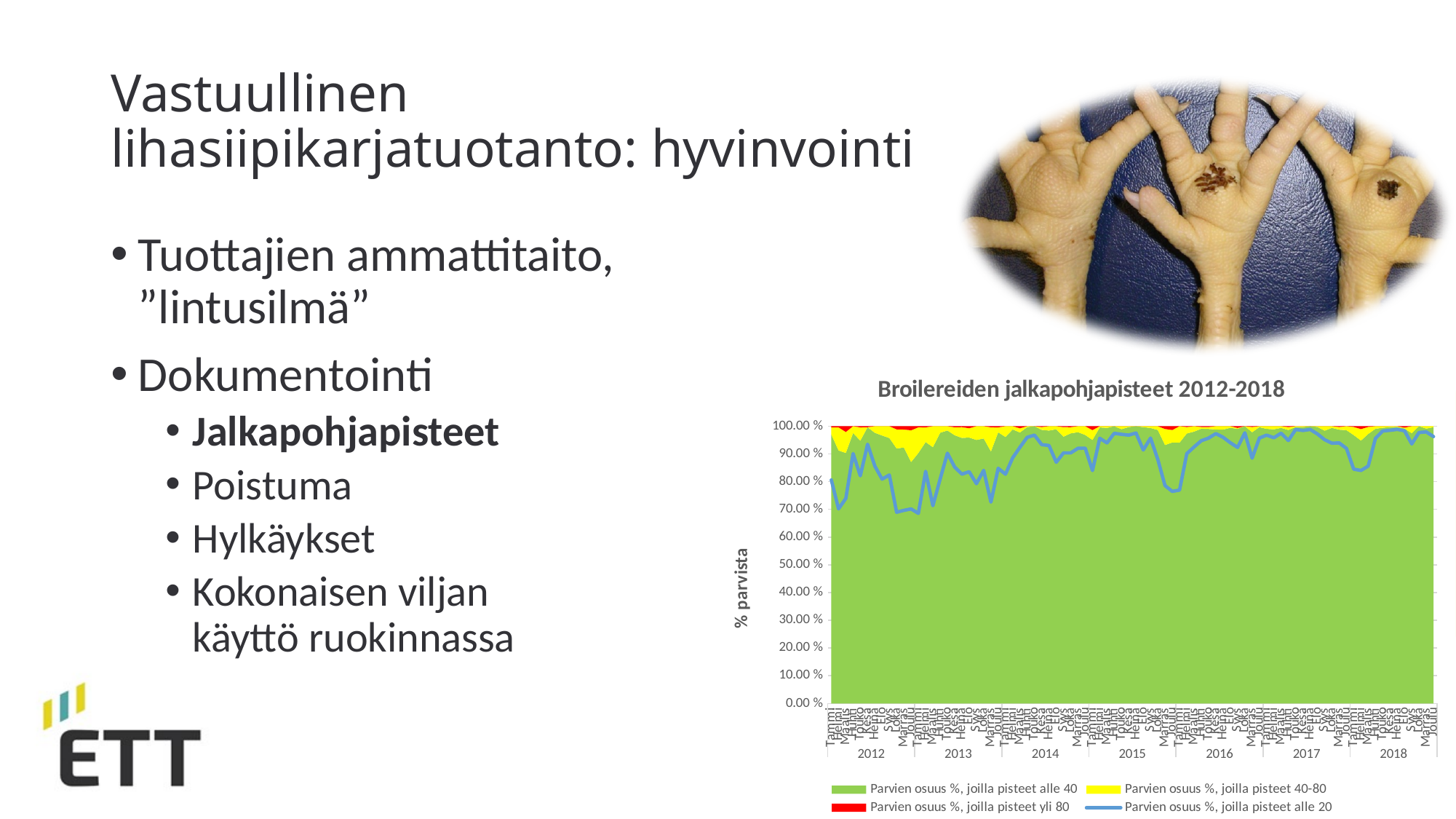
Which series is drawn as a blue line in the chart? Parvien osuus %, joilla pisteet alle 20 How many years are labelled along the x axis of the chart? 7 Is the green area (Parvien osuus %, joilla pisteet alle 40) in 2018 greater or less than 90.00 %? greater Is the lowest value of the blue line (Parvien osuus %, joilla pisteet alle 20) in 2013 greater or less than 80.00 %? less What is the title of the chart? Broilereiden jalkapohjapisteet 2012-2018 Is the value of the blue line (Parvien osuus %, joilla pisteet alle 20) at the end of 2018 greater or less than 90.00 %? greater Does the blue line (Parvien osuus %, joilla pisteet alle 20) generally rise or fall from 2012 to 2018? rise What is the first year shown on the x axis of the chart? 2012 What is the highest value shown on the vertical axis of the chart? 100.00 % What is the label on the vertical axis of the chart? % parvista How many series does the chart legend list? 4 Which series occupies the largest area of the chart? Parvien osuus %, joilla pisteet alle 40